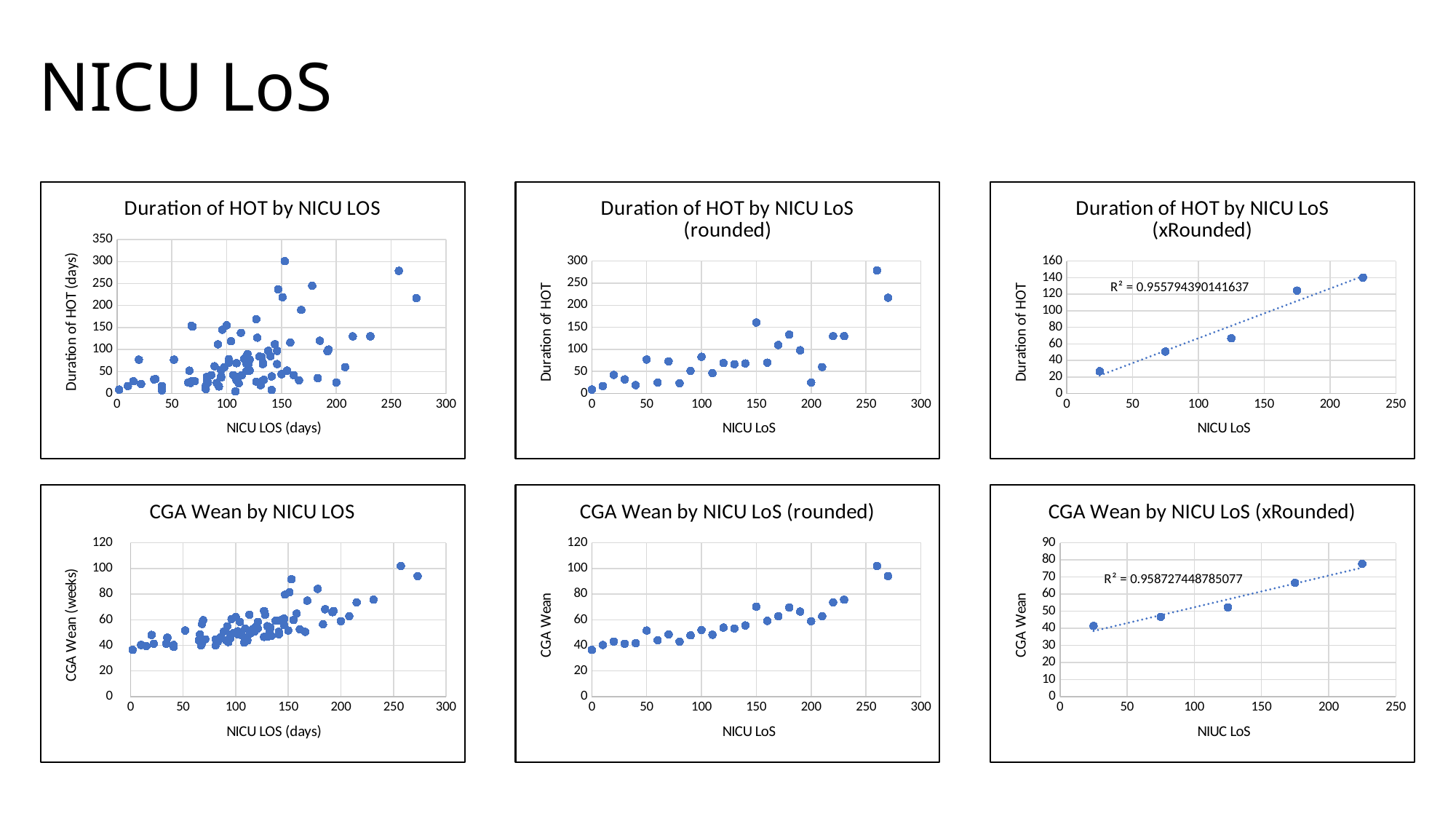
In the "Duration of HOT by NICU LOS" chart (top left), is the highest Duration of HOT value greater or less than 250? greater In the "CGA Wean by NICU LoS (xRounded)" chart (bottom right), which has the higher CGA Wean: the third point from the left or the fourth point from the left? The fourth point from the left What kind of chart is "Duration of HOT by NICU LOS" (top left)? Scatter chart How many data points are plotted in the "Duration of HOT by NICU LoS (xRounded)" chart (top right)? 5 How many charts are shown on the slide? 6 In the "CGA Wean by NICU LoS (xRounded)" chart (bottom right), is the CGA Wean for the leftmost point greater or less than 50? less What R² value is printed on the "CGA Wean by NICU LoS (xRounded)" chart (bottom right)? R² = 0.958727448785077 In the "CGA Wean by NICU LoS (rounded)" chart (bottom middle), do CGA Wean values generally rise or fall as NICU LoS increases? Rise In the "Duration of HOT by NICU LoS (xRounded)" chart (top right), is the Duration of HOT for the rightmost point greater or less than 120? greater What R² value is printed on the "Duration of HOT by NICU LoS (xRounded)" chart (top right)? R² = 0.955794390141637 In the "Duration of HOT by NICU LoS (xRounded)" chart (top right), do the values rise or fall as NICU LoS increases? Rise How many data points are plotted in the "CGA Wean by NICU LoS (xRounded)" chart (bottom right)? 5